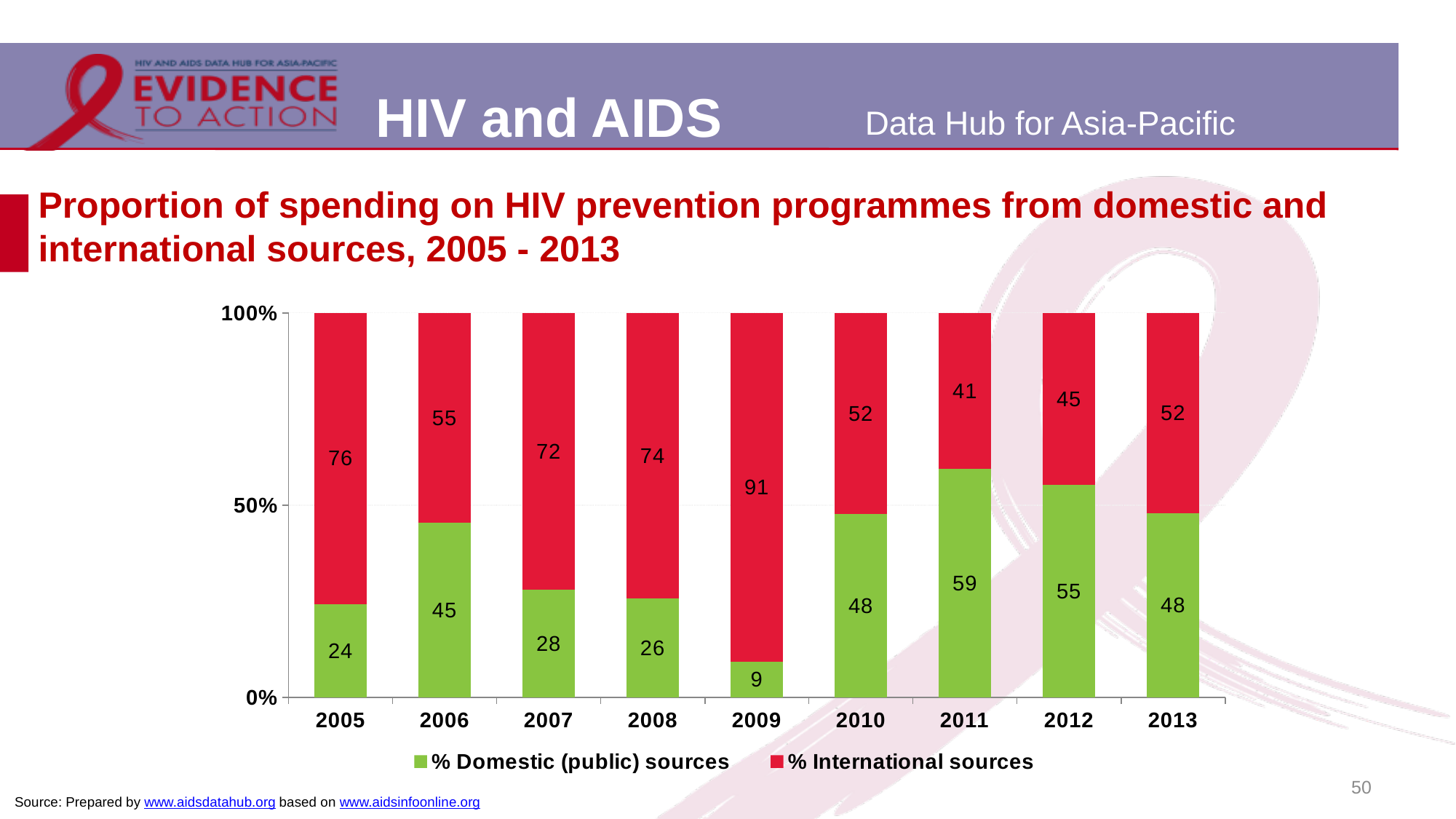
What is the value for % International sources in 2011? 41 What is the difference between the % International sources values for 2005 and 2013? 24 How many years are shown on the x axis? 9 Which year has the highest value for % International sources? 2009 Which colour represents % International sources in the chart? Red What is the value for % Domestic (public) sources in 2009? 9 How many series does the legend list? 2 What kind of chart is shown on the slide? Stacked bar chart Which year has the lowest value for % International sources? 2011 Which year has the highest value for % Domestic (public) sources? 2011 What is the value for % Domestic (public) sources in 2006? 45 Which is larger: % Domestic (public) sources in 2012 or in 2010? 2012